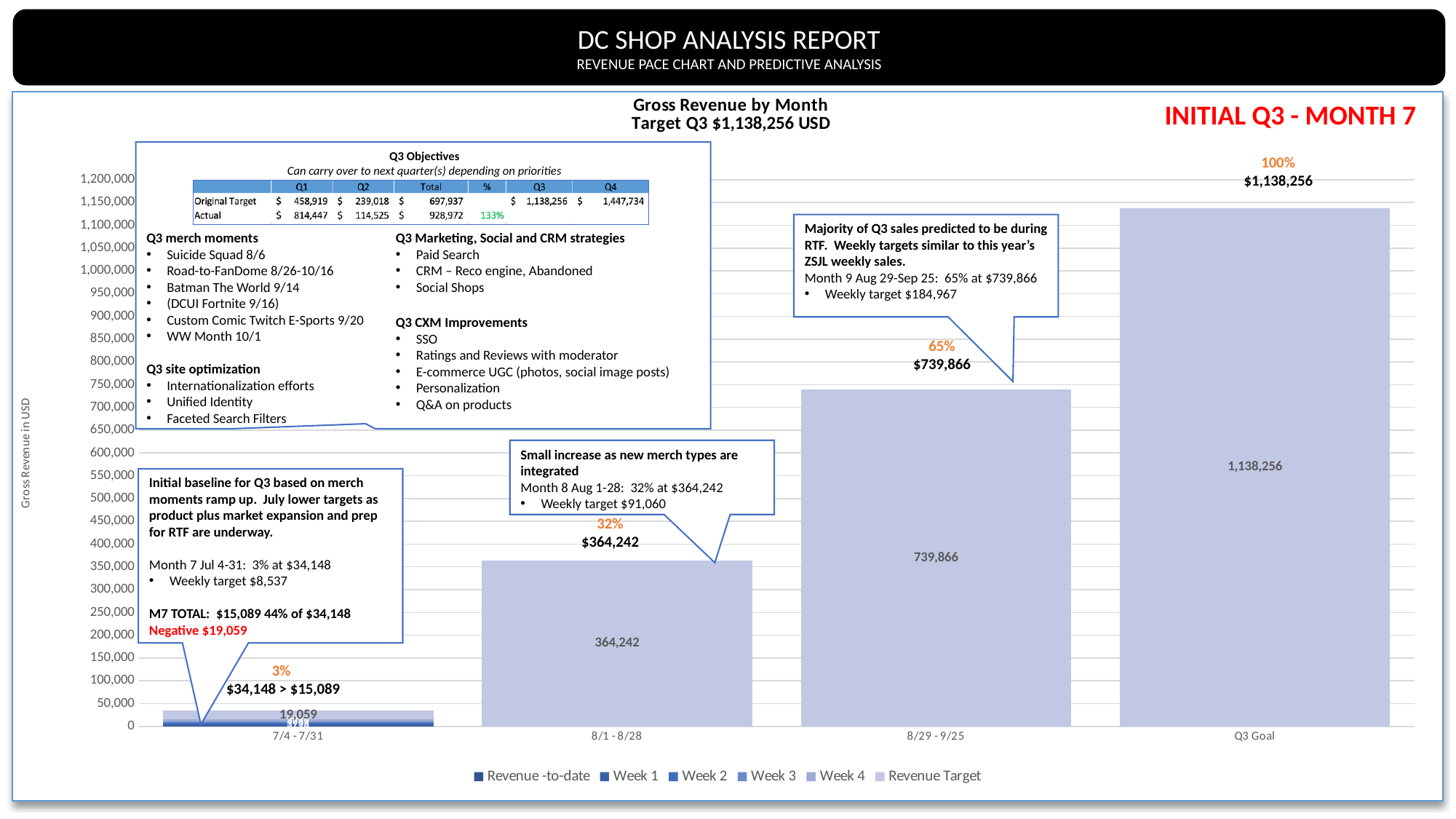
What is the Revenue Target value labelled for the 8/1 - 8/28 bar? 364,242 How many series does the chart legend list? 6 What is the Revenue Target value labelled for the 7/4 - 7/31 bar? 19,059 What is the difference between the Revenue Target values for 8/29 - 9/25 and 8/1 - 8/28? 375,624 What type of chart is shown on the slide? bar chart How many categories are shown on the x axis of the chart? 4 What is the Revenue Target value labelled for the 8/29 - 9/25 bar? 739,866 Do the bar values rise or fall moving left to right along the x axis? rise Which category has the highest bar in the chart? Q3 Goal Which category has the lowest bar in the chart? 7/4 - 7/31 What is the title of the chart? Gross Revenue by Month Target Q3 $1,138,256 USD What is the value labelled on the Q3 Goal bar? 1,138,256